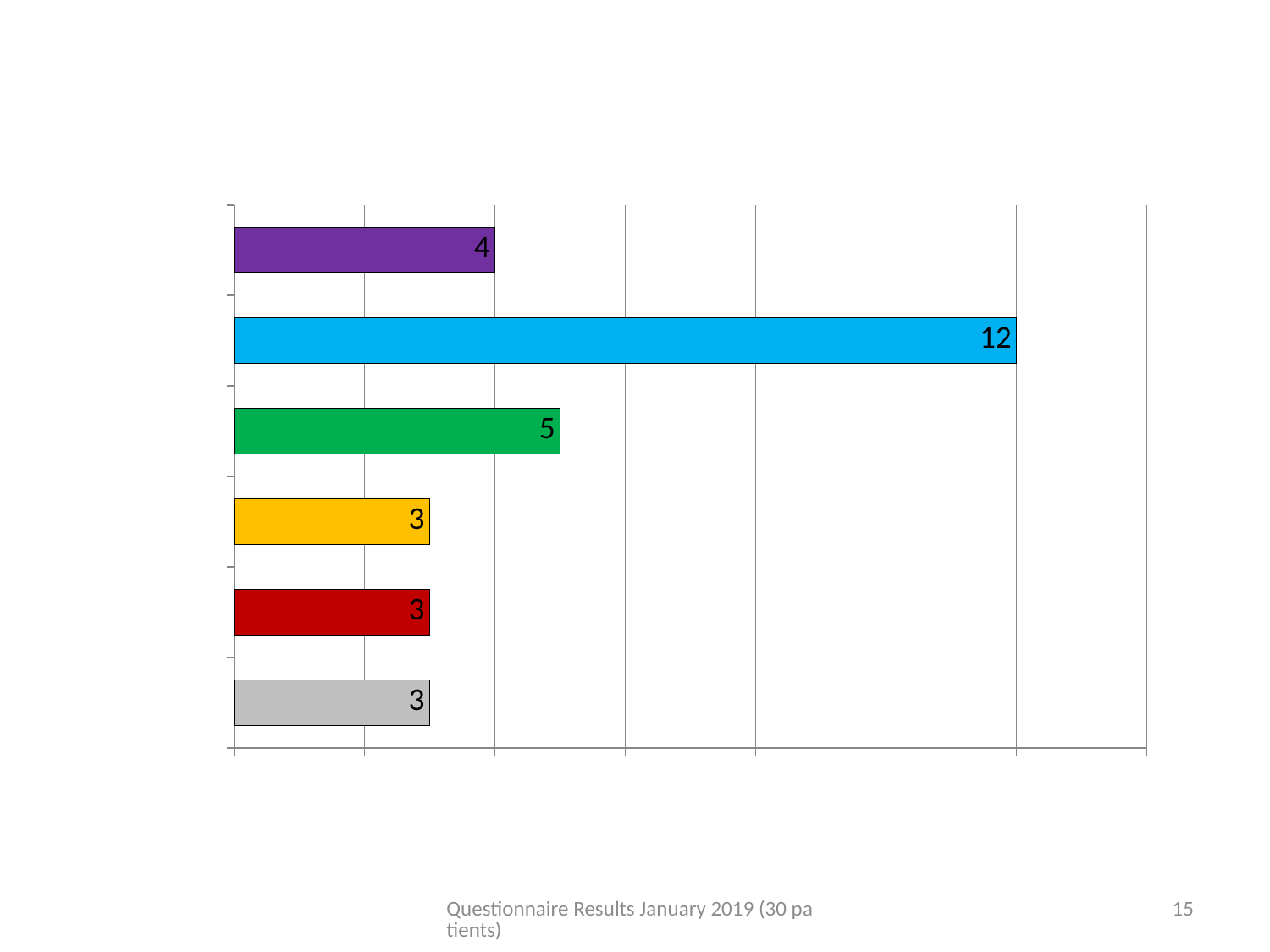
What is the value shown on the purple bar at the top of the chart? 4 What kind of chart is shown on the slide? bar chart Which is larger, the value of the purple bar or the value of the yellow bar? purple bar Which colour bar has the highest value? blue What is the value shown on the green bar? 5 What is the value shown on the blue bar? 12 How many bars are plotted in the chart? 6 What is the value shown on the grey bar at the bottom of the chart? 3 What is the lowest value shown on any bar in the chart? 3 What is the difference between the green bar's value and the purple bar's value? 1 How many bars in the chart have a value of 3? 3 What is the difference between the blue bar's value and the green bar's value? 7